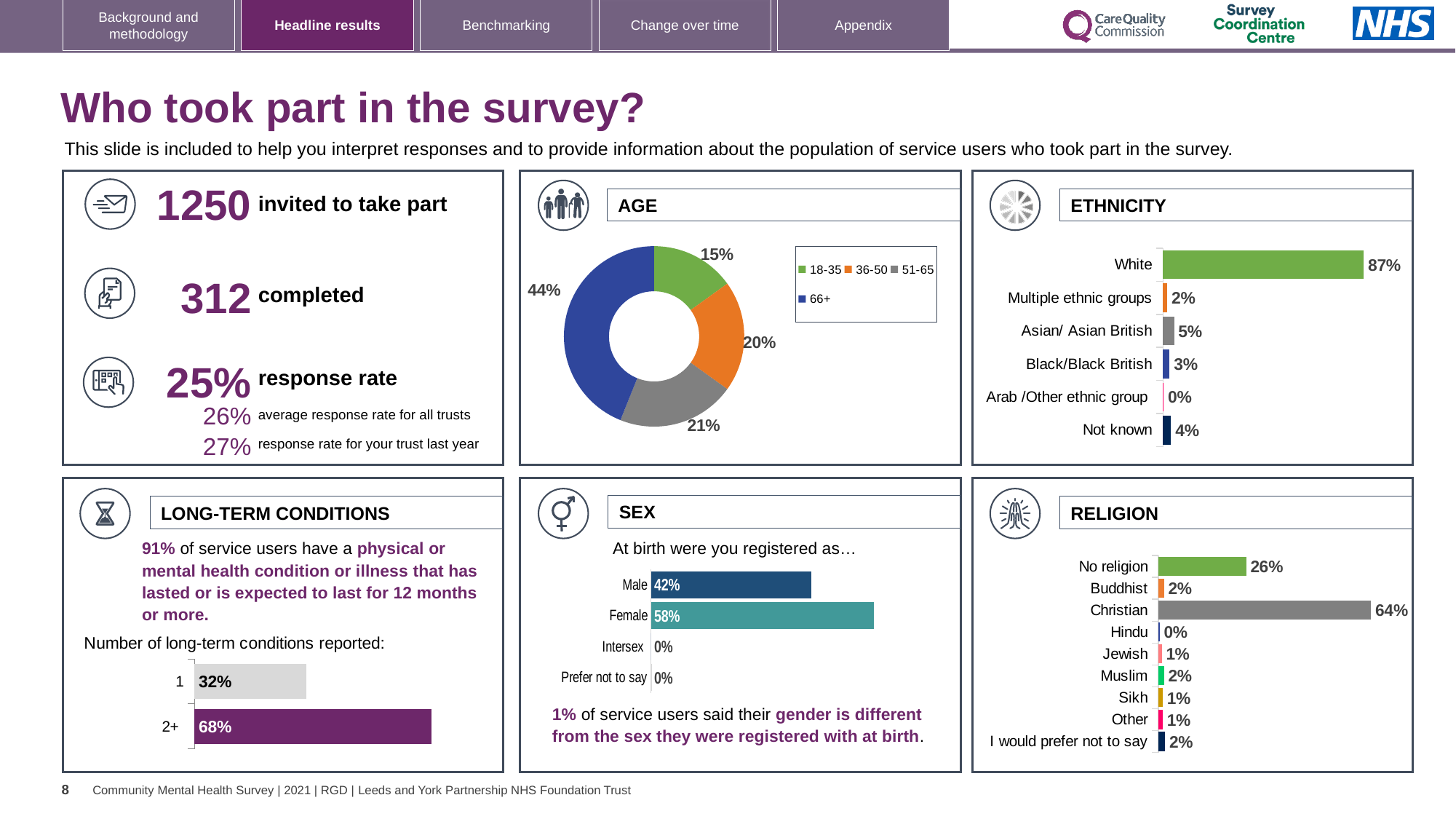
In the ETHNICITY chart, what is the value for Asian/ Asian British? 5% In the ETHNICITY chart, which category has the highest value? White How many entries does the legend of the AGE chart list? 4 In the AGE chart, what share of respondents were aged 66+? 44% In the RELIGION chart, what is the value for Christian? 64% In the AGE chart, which age group has the smallest share? 18-35 In the LONG-TERM CONDITIONS chart, what percentage reported 2+ conditions? 68% What kind of chart is the AGE chart? Donut chart How many categories are shown in the RELIGION chart? 9 How many categories are shown in the ETHNICITY chart? 6 In the SEX chart, which is larger, Male or Female? Female In the ETHNICITY chart, what is the difference between White and Not known? 83%